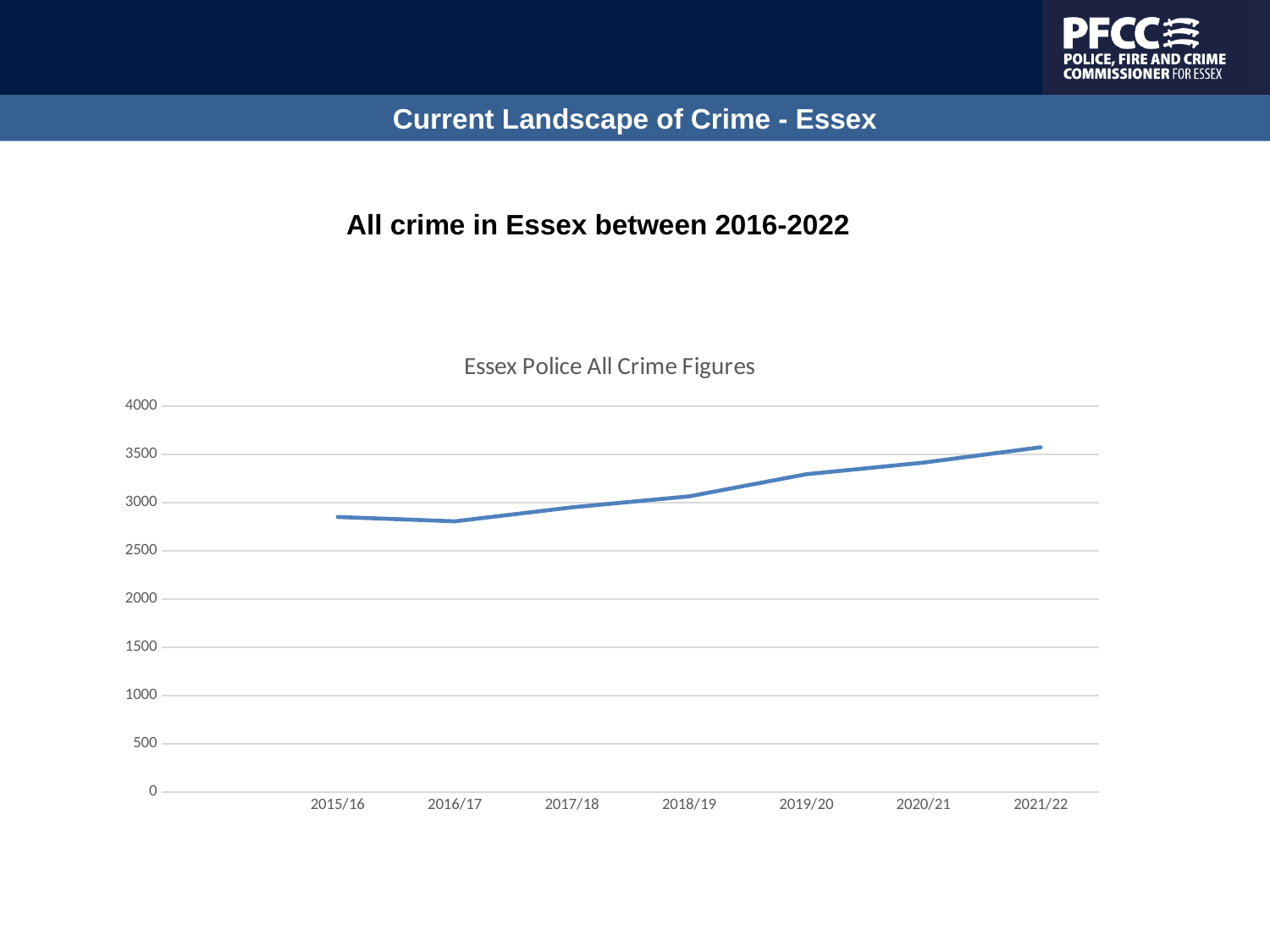
What kind of chart is shown on the slide? line chart Is the value for 2015/16 greater or less than 3000? less Which year has the highest all crime figure? 2021/22 Is the value for 2020/21 greater or less than 3500? less What is the title of the chart? Essex Police All Crime Figures Is the value for 2016/17 greater or less than 3000? less Do the all crime figures generally rise or fall from 2016/17 to 2021/22? rise How many years are plotted on the x axis of the chart? 7 Which is larger, the value for 2021/22 or the value for 2015/16? 2021/22 What is the highest value shown on the y axis of the chart? 4000